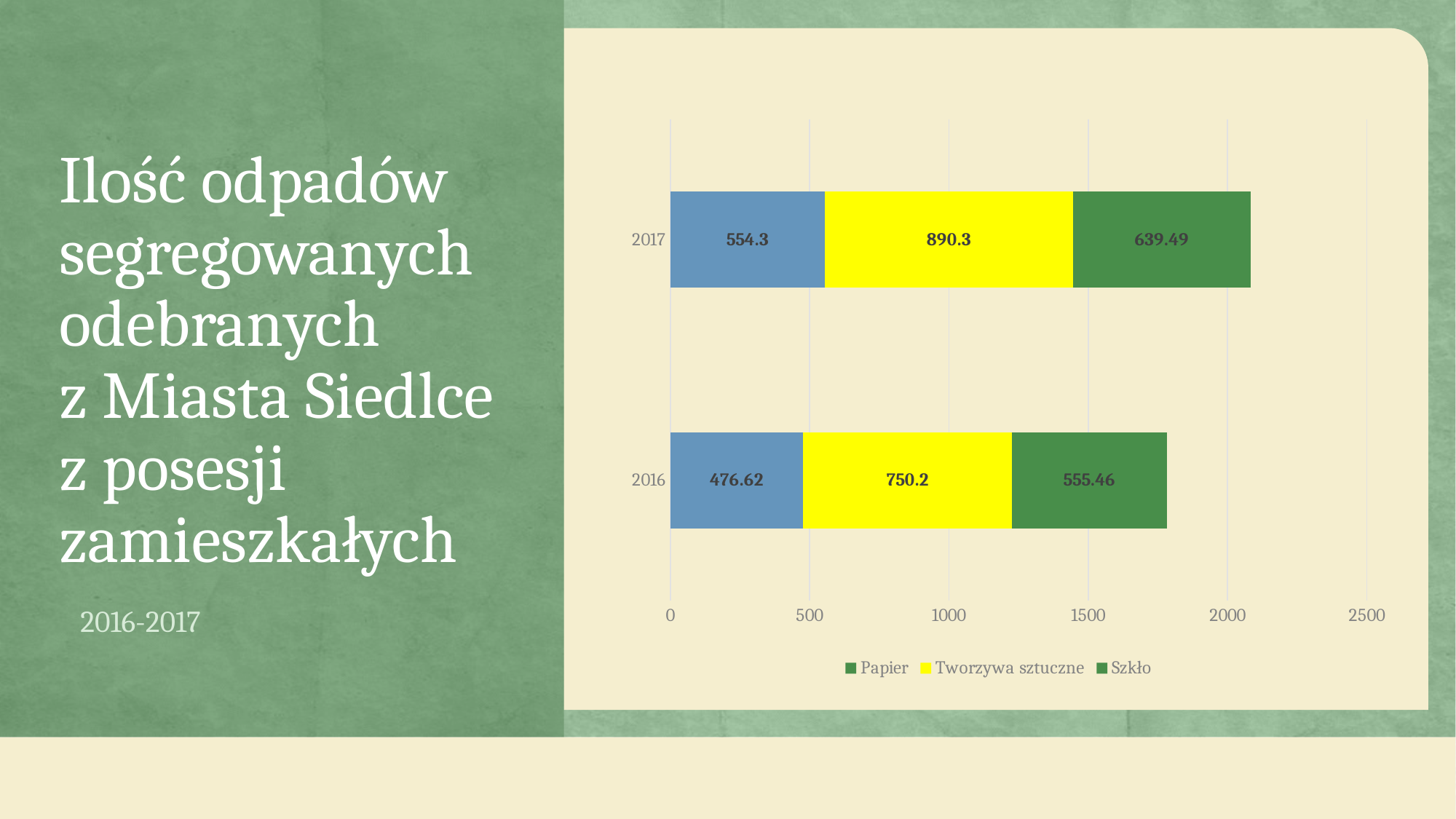
What is the value for Papier in 2016? 476.62 What kind of chart is shown on the slide? Stacked bar chart What is the difference between the Tworzywa sztuczne values for 2017 and 2016? 140.1 How many series does the legend list? 3 What is the value for Szkło in 2016? 555.46 What is the value for Tworzywa sztuczne in 2017? 890.3 Which is larger: Papier in 2017 or Papier in 2016? Papier in 2017 Which series has the highest value in 2017? Tworzywa sztuczne What is the total of the stacked bar for 2016? 1782.28 What is the value for Szkło in 2017? 639.49 Which series has the lowest value in 2016? Papier What is the total of the stacked bar for 2017? 2084.09